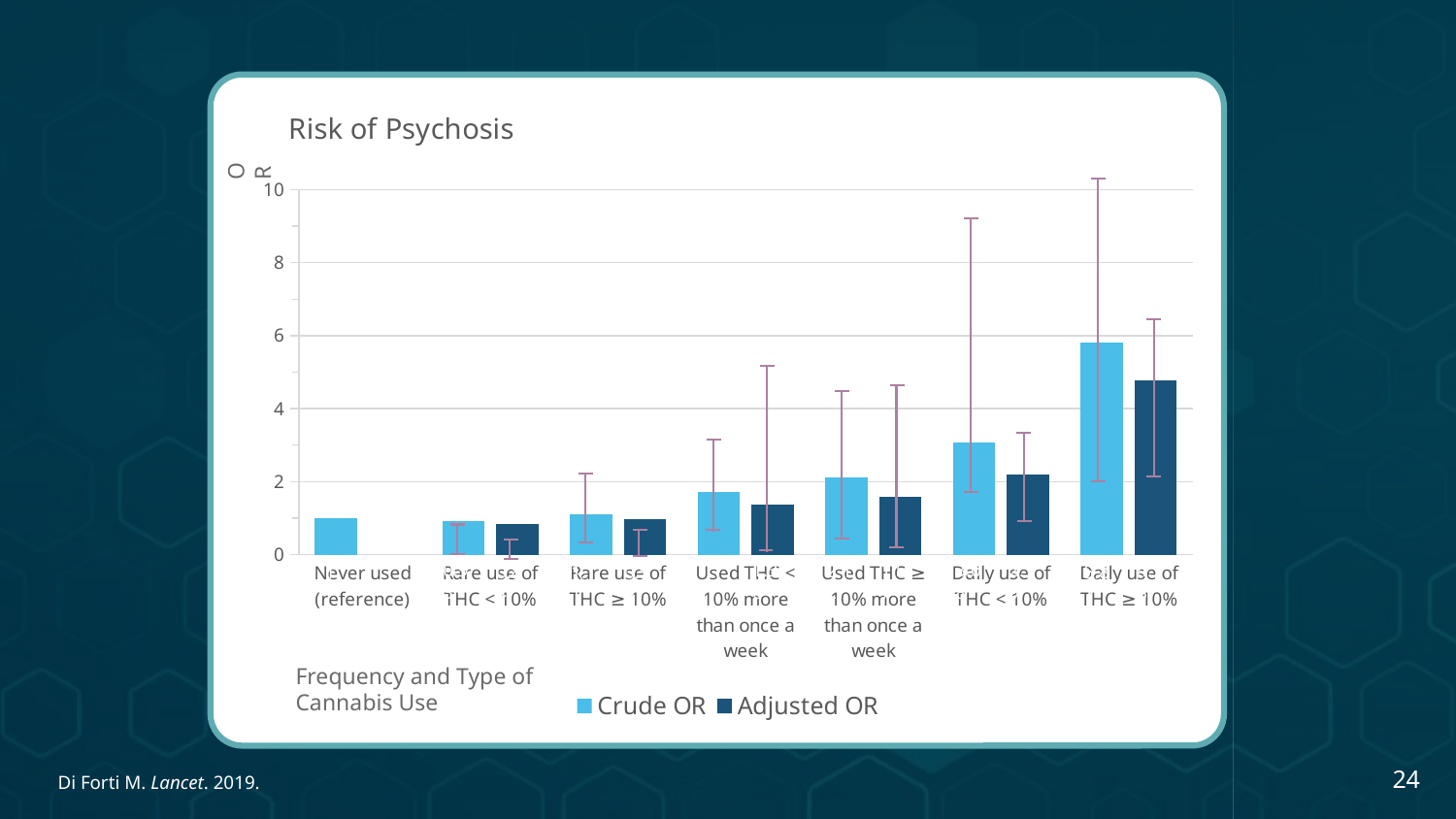
How many categories are shown on the x axis? 7 What is the label of the x axis? Frequency and Type of Cannabis Use How many series does the legend list? 2 What is the title of the chart? Risk of Psychosis Do the Crude OR values generally rise or fall from left to right across the categories? rise Which is larger for Daily use of THC < 10%: the Crude OR or the Adjusted OR? Crude OR Is the Crude OR for Rare use of THC < 10% greater or less than 2? less What kind of chart is shown on the slide? bar chart Is the Adjusted OR for Daily use of THC < 10% greater or less than 4? less Which category has the highest Adjusted OR? Daily use of THC ≥ 10% Which category has the highest Crude OR? Daily use of THC ≥ 10% Is the Crude OR for Daily use of THC ≥ 10% greater or less than 4? greater